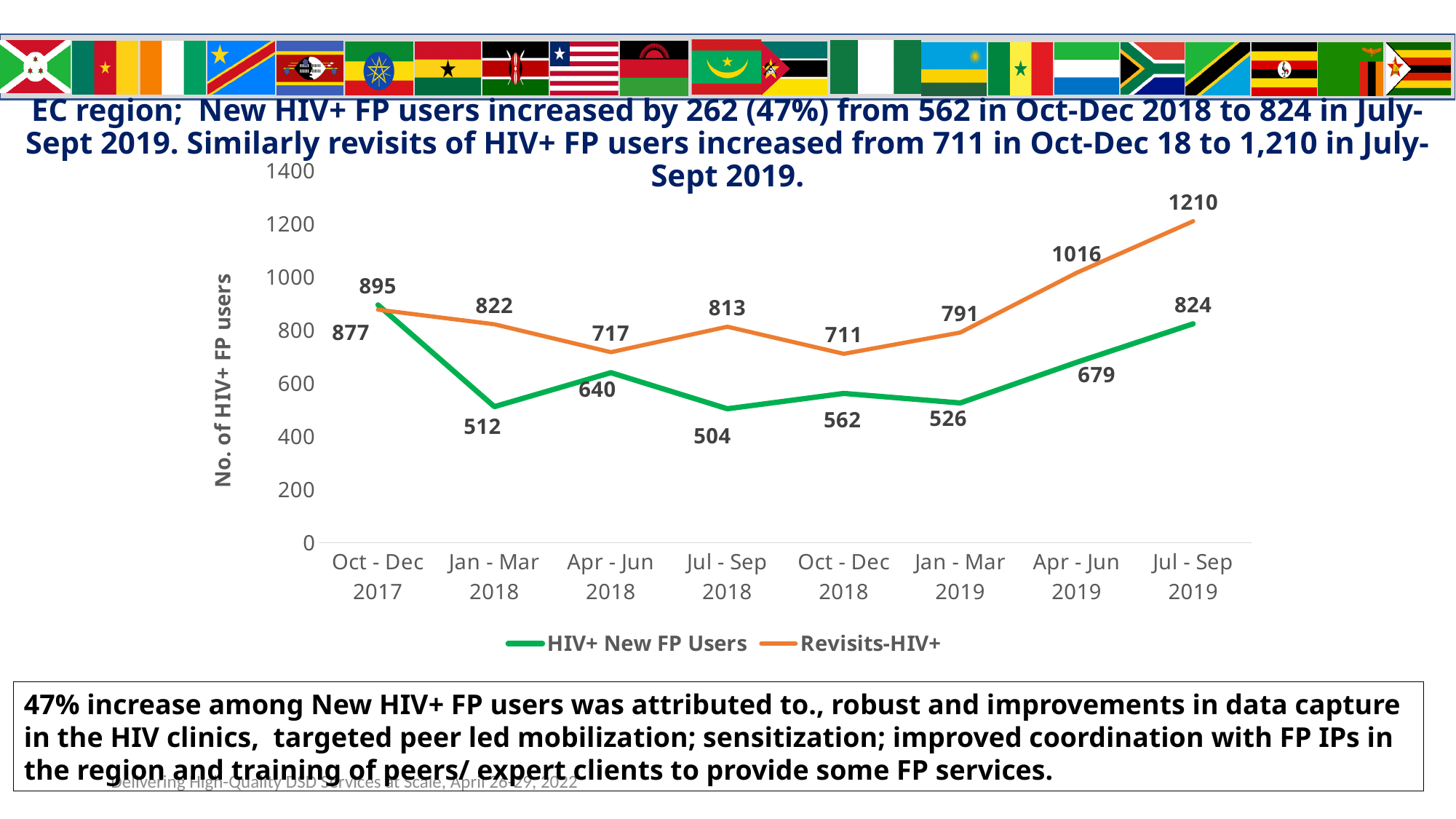
What is the value for HIV+ New FP Users in Jan - Mar 2018? 512 What is the title of the vertical axis? No. of HIV+ FP users In which quarter is Revisits-HIV+ highest? Jul - Sep 2019 What is the difference between Revisits-HIV+ in Jul - Sep 2019 and Apr - Jun 2019? 194 How many series does the legend list? 2 What kind of chart is shown on the slide? line chart In Apr - Jun 2019, which series has the larger value, HIV+ New FP Users or Revisits-HIV+? Revisits-HIV+ Do the values for HIV+ New FP Users rise or fall from Oct - Dec 2018 to Jul - Sep 2019? rise In which quarter is HIV+ New FP Users lowest? Jul - Sep 2018 How many quarters are plotted along the x axis? 8 What is the value for Revisits-HIV+ in Jul - Sep 2019? 1210 What is the value for Revisits-HIV+ in Oct - Dec 2018? 711